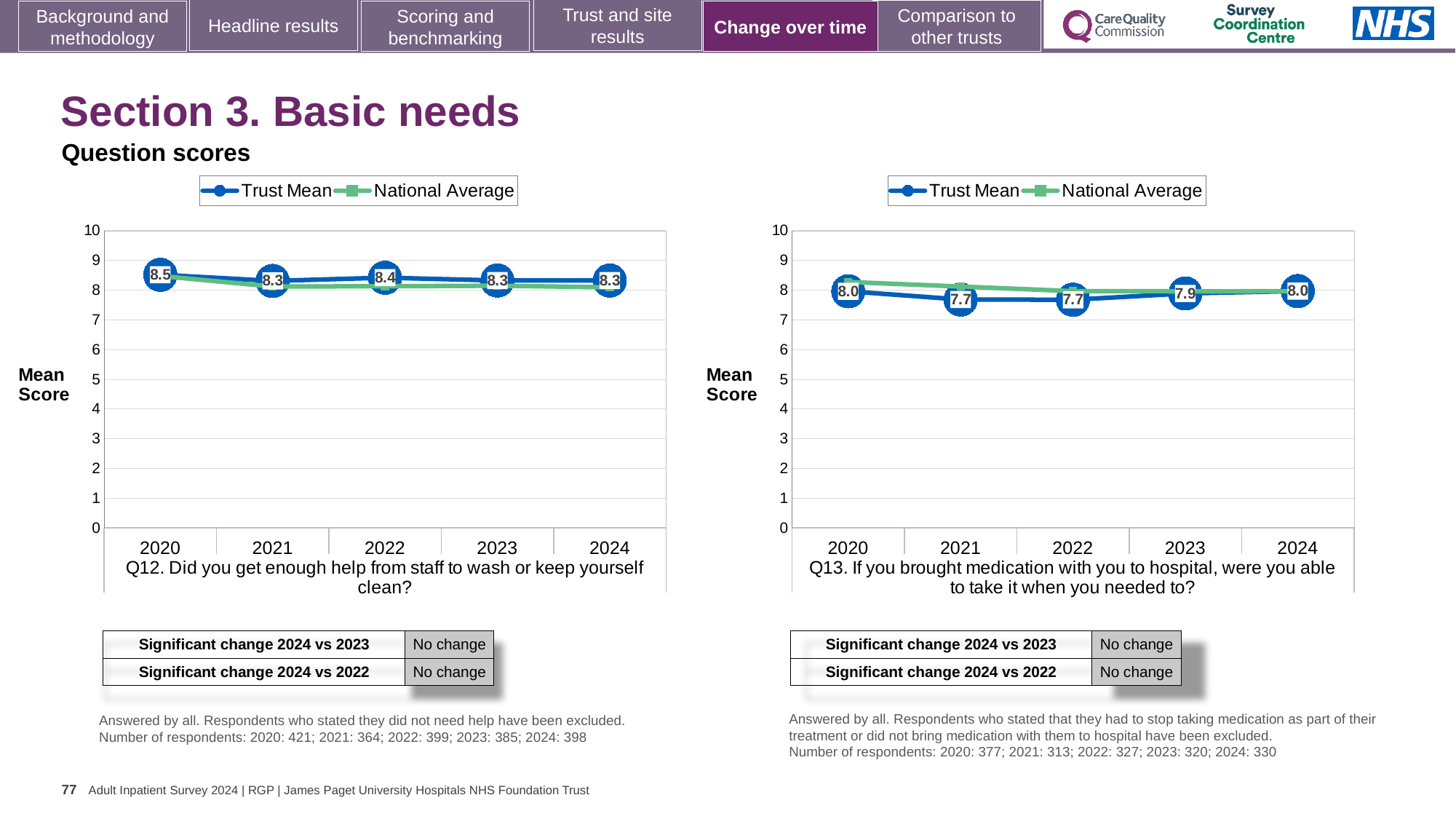
On the Q12 chart (left), what is the Trust Mean score for 2020? 8.5 On the Q13 chart (right), which year has the larger Trust Mean, 2021 or 2023? 2023 What kind of chart is the Q12 chart (left)? Line chart On the Q13 chart (right), is the National Average for 2020 greater or less than 8? greater On the Q13 chart (right), what is the Trust Mean score for 2023? 7.9 On the Q13 chart (right), what is the difference between the Trust Mean in 2020 and in 2021? 0.3 On the Q12 chart (left), what is the difference between the Trust Mean in 2020 and in 2024? 0.2 On the Q13 chart (right), what is the Trust Mean score for 2021? 7.7 On the Q12 chart (left), in which year is the Trust Mean highest? 2020 On the Q12 chart (left), what is the Trust Mean score for 2022? 8.4 How many years are shown on the x axis of the Q12 chart (left)? 5 How many series does the legend of the Q13 chart (right) list? 2